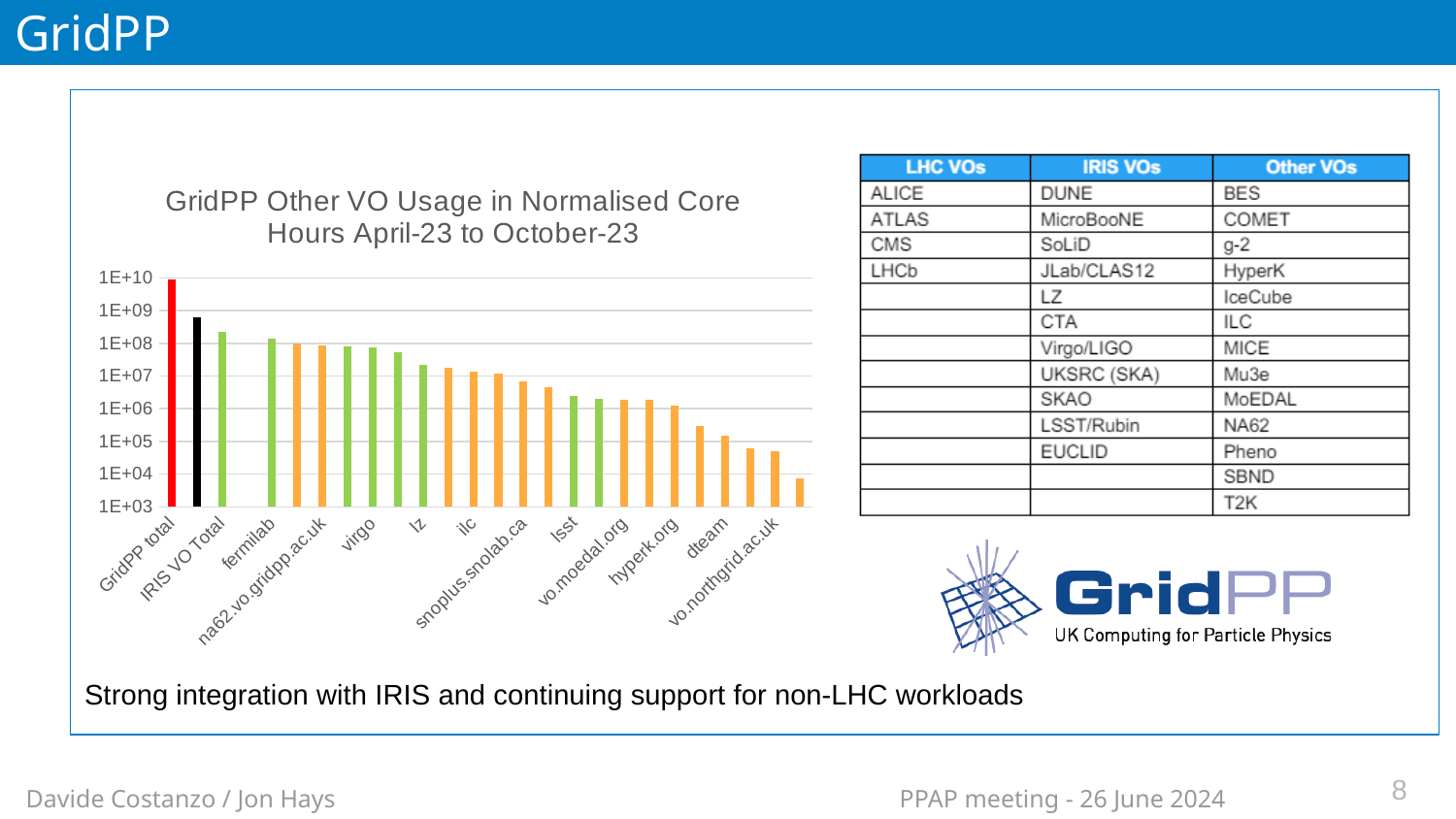
Is the value for IRIS VO Total greater or less than 1E+09? less Which is larger, the value for IRIS VO Total or the value for fermilab? IRIS VO Total Which is larger, the value for GridPP total or the value for IRIS VO Total? GridPP total Is the value for IRIS VO Total greater or less than 1E+08? greater What is the title of the chart on the slide? GridPP Other VO Usage in Normalised Core Hours April-23 to October-23 What is the highest tick value shown on the y axis of the chart? 1E+10 Is the value for GridPP total greater or less than 1E+09? greater Do the bar values generally rise or fall from left to right along the x axis? fall What colour is the bar for GridPP total? red What kind of chart is shown on the slide? bar chart Which category has the highest value in the chart? GridPP total